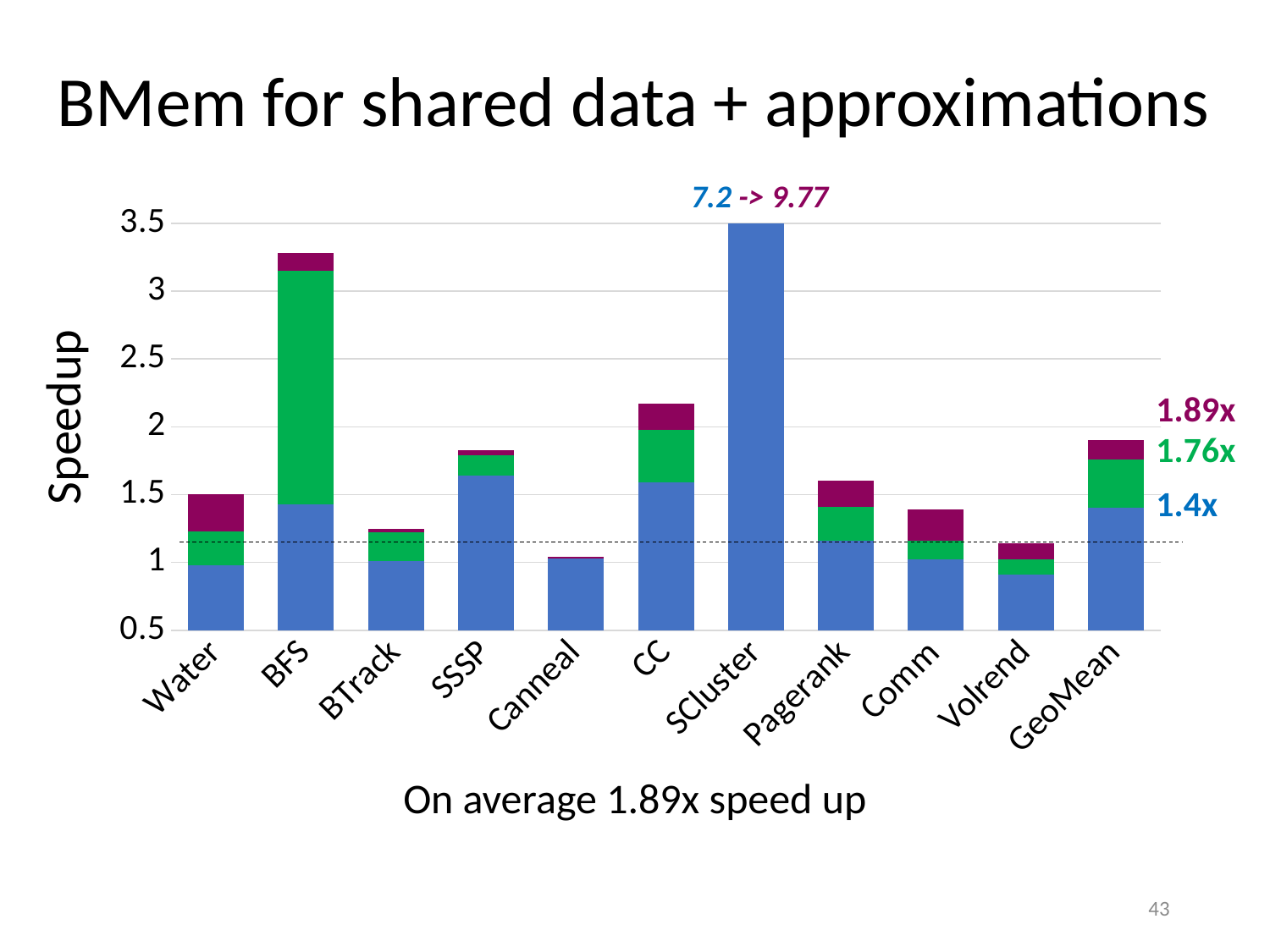
According to the slide, what is the average speed up? 1.89x What kind of chart is shown on the slide? bar chart What is the label on the y axis of the chart? Speedup Which category has the shortest bar in the chart? Canneal Is the total speedup for Comm greater or less than 1.5? less Which category has the tallest bar in the chart? SCluster Which has the taller bar, BFS or CC? BFS Is the total speedup for BFS greater or less than 3? greater How many categories are shown along the x axis of the chart? 11 What annotation is printed above the SCluster bar? 7.2 -> 9.77 What is the topmost value labelled next to the GeoMean bar? 1.89x What is the lowest value labelled next to the GeoMean bar? 1.4x